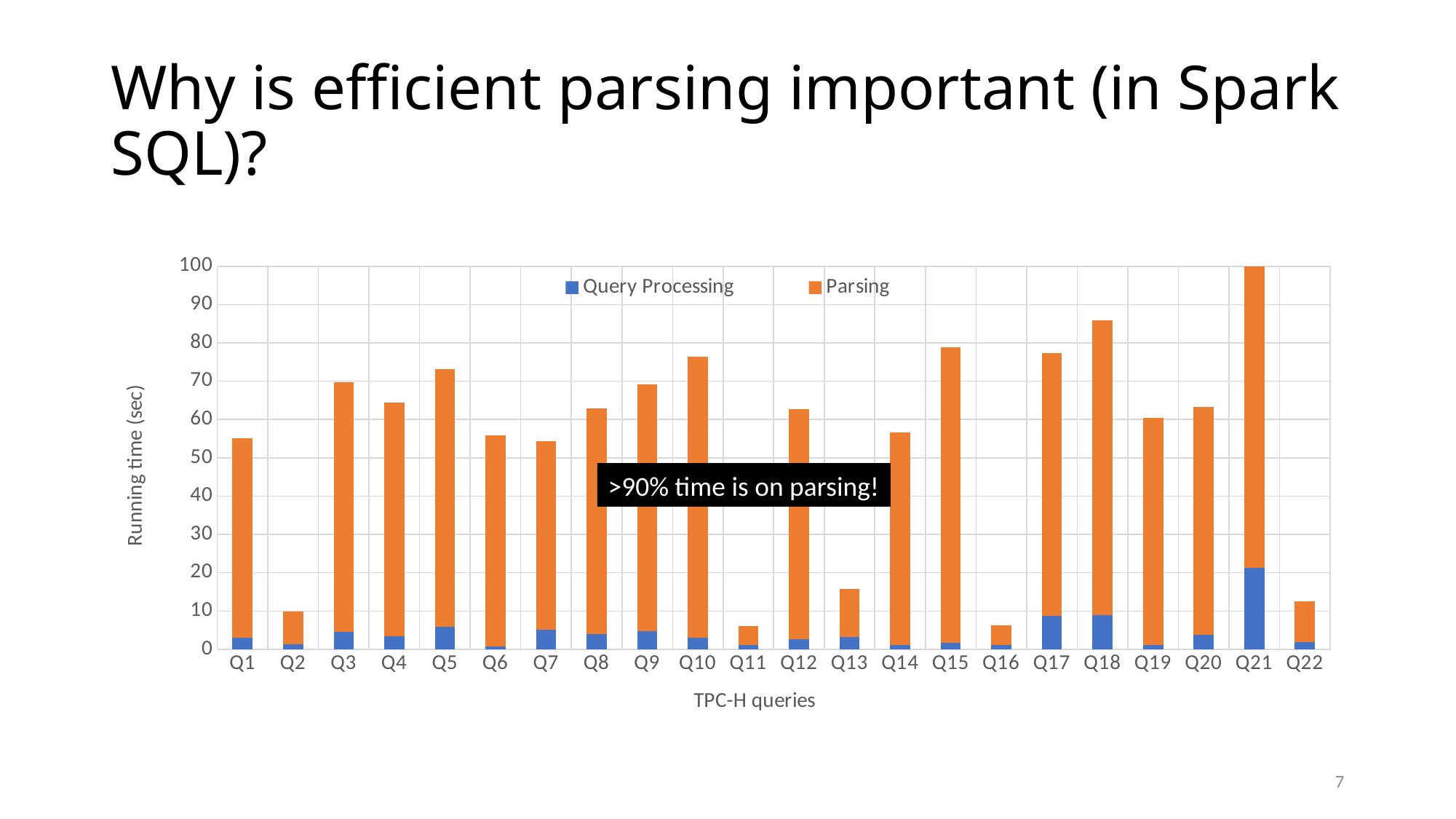
Which has the larger total running time, Q17 or Q18? Q18 Is the total running time for Q13 greater or less than 20? less Is the total running time for Q18 greater or less than 80? greater What is the label on the y axis? Running time (sec) What kind of chart is shown on the slide? Stacked bar chart Is the total running time for Q21 greater or less than 90? greater Which query has the larger Query Processing time, Q21 or Q17? Q21 How many series does the legend list? 2 What does the annotation box on the chart say? >90% time is on parsing! How many TPC-H queries are plotted along the x axis? 22 Which query has the highest total running time? Q21